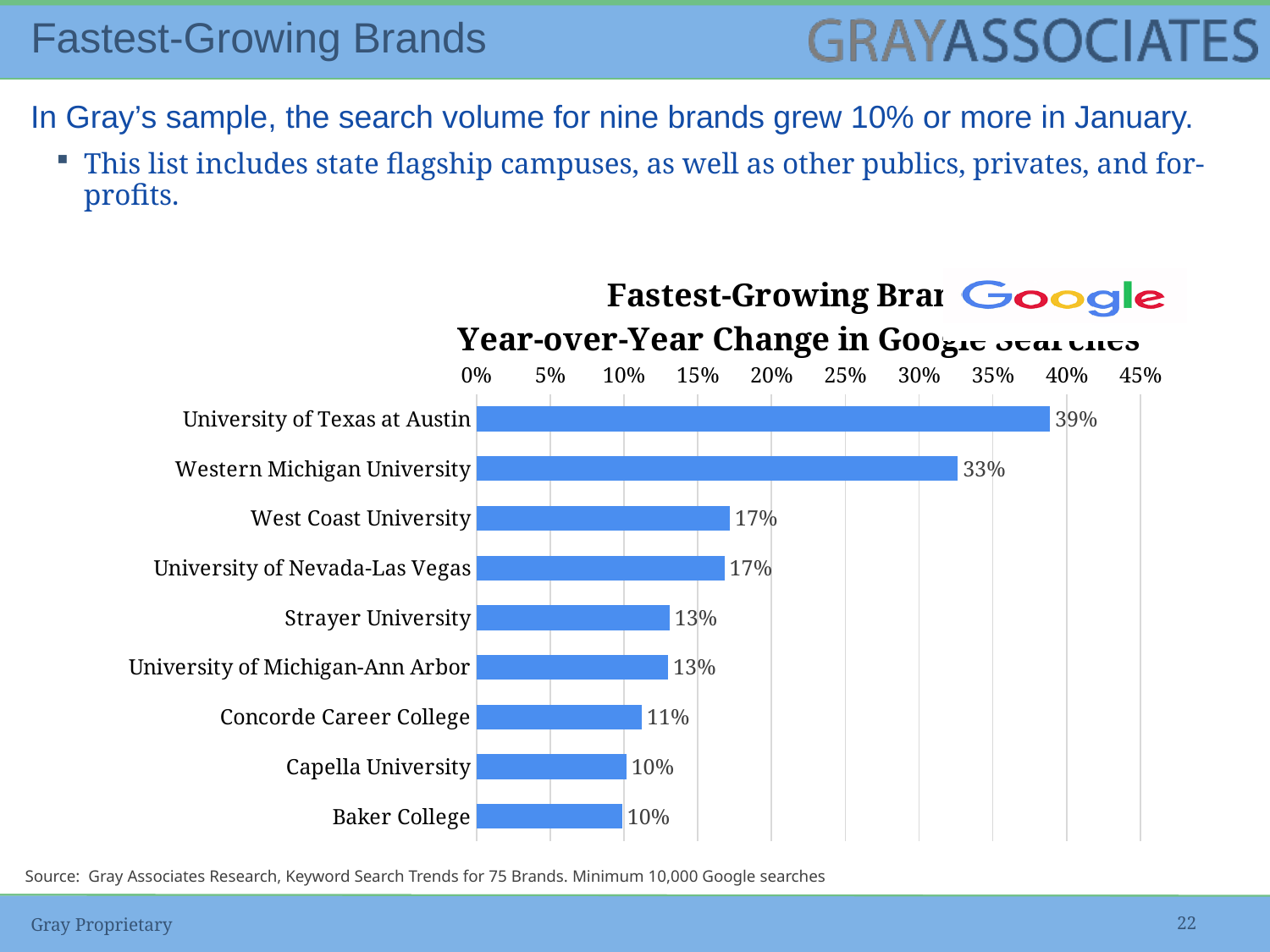
How many brands are shown in the chart? 9 Which is larger, the value for Western Michigan University or the value for University of Nevada-Las Vegas? Western Michigan University What is the difference between the values for University of Texas at Austin and Western Michigan University? 6% What is the value shown for Western Michigan University? 33% Which brand has the highest year-over-year change in Google searches? University of Texas at Austin What kind of chart is shown on the slide? Bar chart What is the difference between the values for West Coast University and Capella University? 7% Is the value for University of Texas at Austin greater or less than 35%? greater What is the highest value shown on the chart's axis? 45% What is the year-over-year change in Google searches for University of Texas at Austin? 39% What is the value shown for Concorde Career College? 11% What is the value shown for Strayer University? 13%